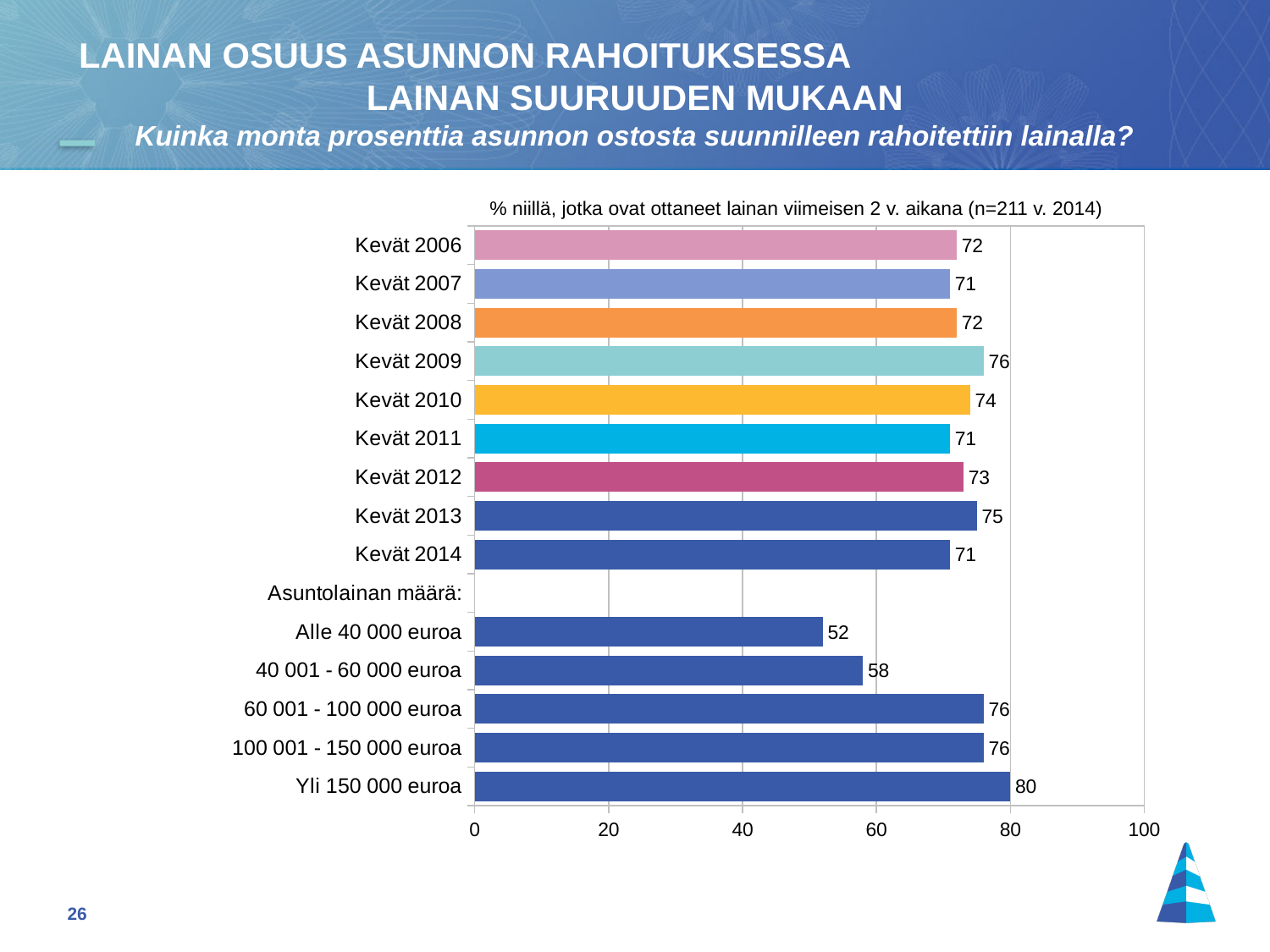
What is the value for 60 001 - 100 000 euroa? 76 Is the value for 40 001 - 60 000 euroa greater or less than 60? less What is the difference between the values for Yli 150 000 euroa and Alle 40 000 euroa? 28 How many loan-size categories (under Asuntolainan määrä) are shown with bars? 5 What kind of chart is shown on the slide? bar chart What is the value for Kevät 2014? 71 What is the value for Alle 40 000 euroa? 52 What is the difference between the values for Kevät 2013 and Kevät 2014? 4 Which category has the highest value in the chart? Yli 150 000 euroa Which category has the lowest value in the chart? Alle 40 000 euroa What is the value for Kevät 2009? 76 Which is larger, the value for Kevät 2010 or the value for Kevät 2012? Kevät 2010